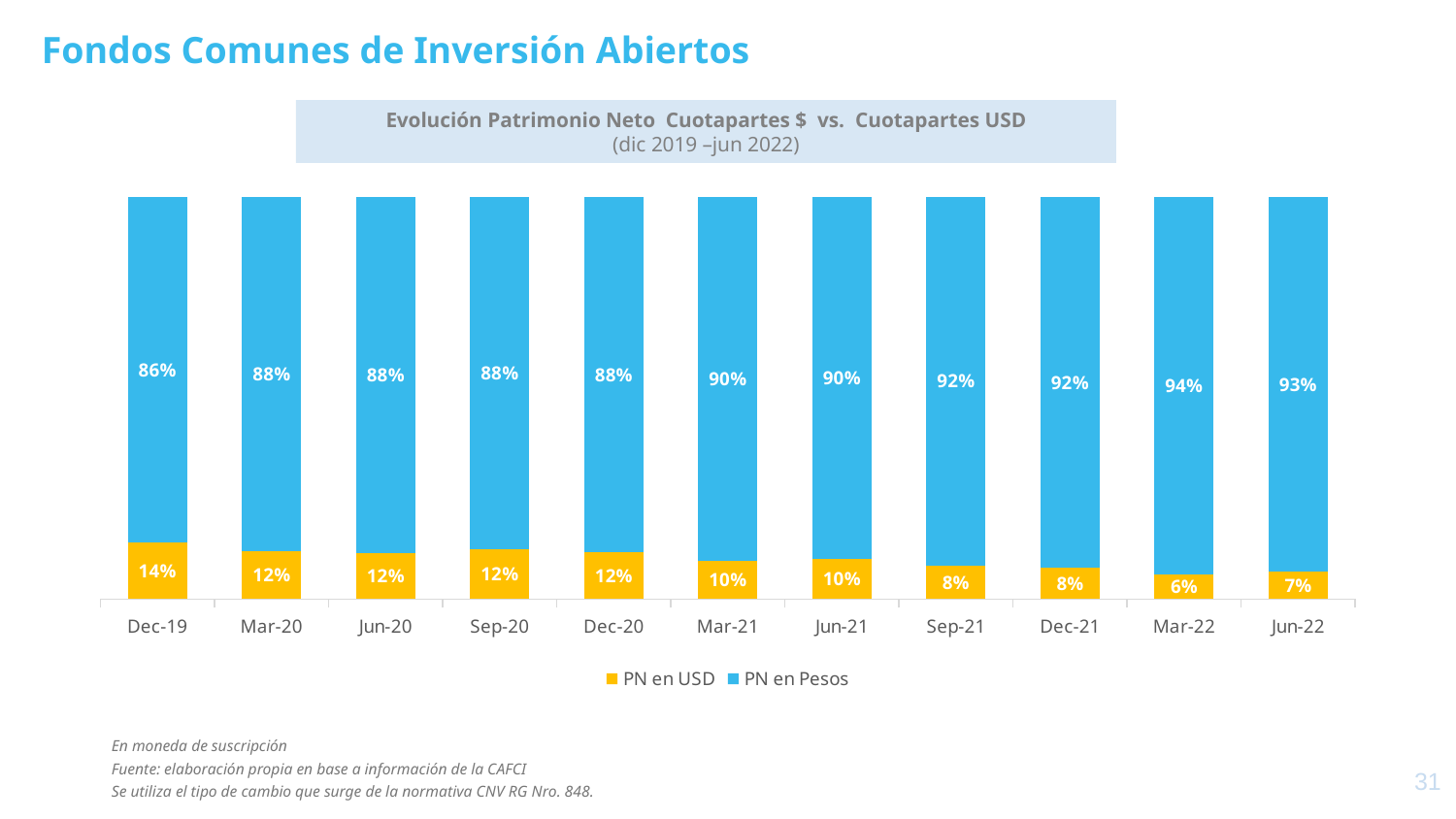
How many periods are shown on the x axis? 11 In which period is PN en USD lowest? Mar-22 What is the total of the stacked bar for Mar-21? 100% Does PN en USD generally rise or fall from Dec-19 to Jun-22? Fall How many series does the legend list? 2 What is the value for PN en Pesos in Jun-22? 93% Which is larger, PN en USD in Dec-19 or PN en USD in Jun-22? PN en USD in Dec-19 In which period is PN en Pesos highest? Mar-22 What is the difference between PN en Pesos and PN en USD in Dec-20? 76% What kind of chart is shown? Stacked bar chart What is the value for PN en USD in Dec-19? 14% What is the value for PN en Pesos in Sep-21? 92%